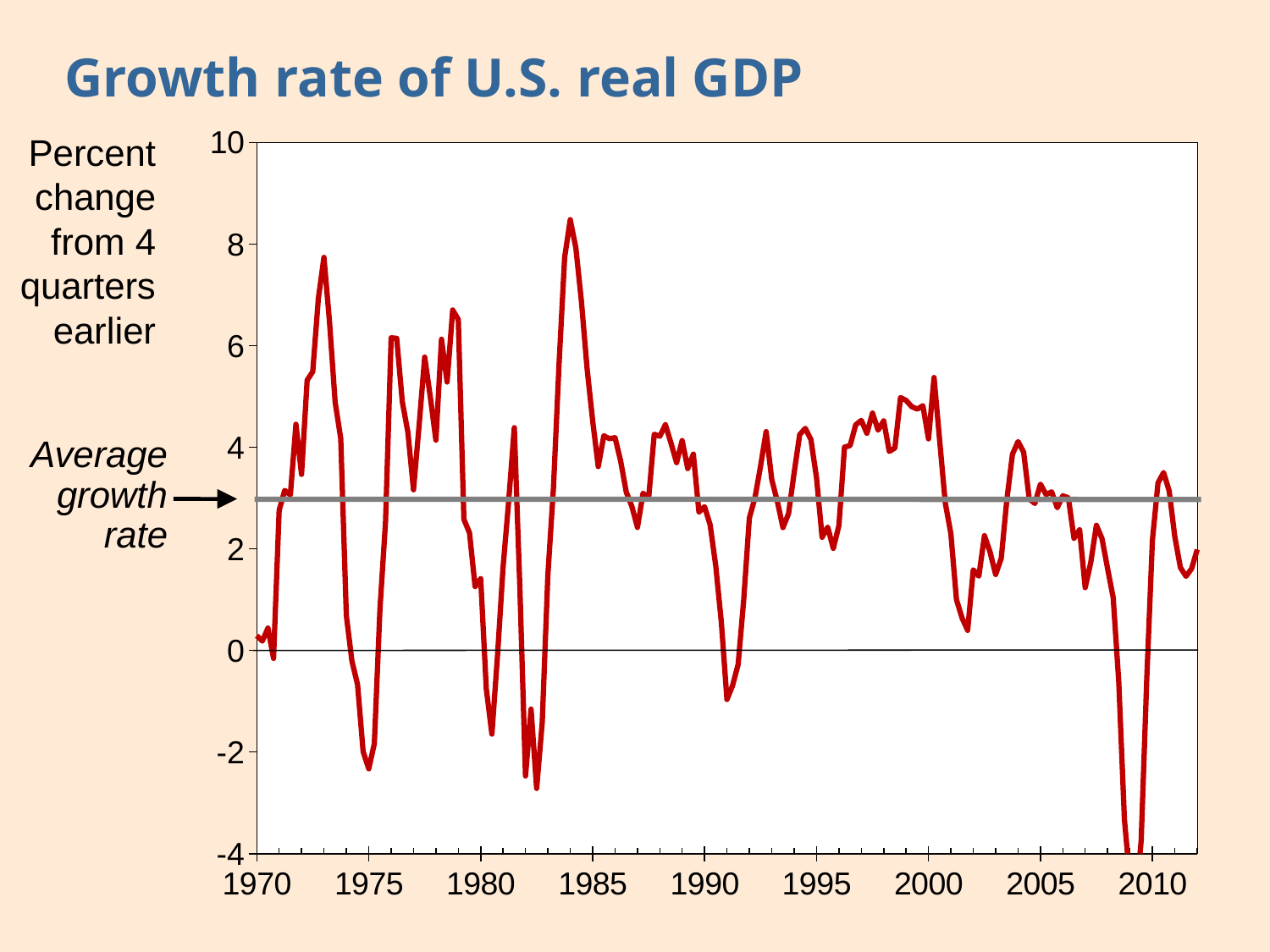
Is the peak growth rate around 1984 greater or less than 8? greater What does the horizontal gray line on the chart represent? Average growth rate How many year labels are shown on the x axis? 9 Is the average growth rate line greater or less than 2? greater Does the growth rate rise or fall between 2007 and 2009? fall Is the peak growth rate around 1973 greater or less than 6? greater Which is higher: the peak growth rate around 1984 or the peak around 1973? 1984 What kind of chart is shown on the slide? line chart Around which year does the growth rate reach its lowest value on the chart? 2009 What is the title of the chart? Growth rate of U.S. real GDP Around which year does the growth rate reach its highest value on the chart? 1984